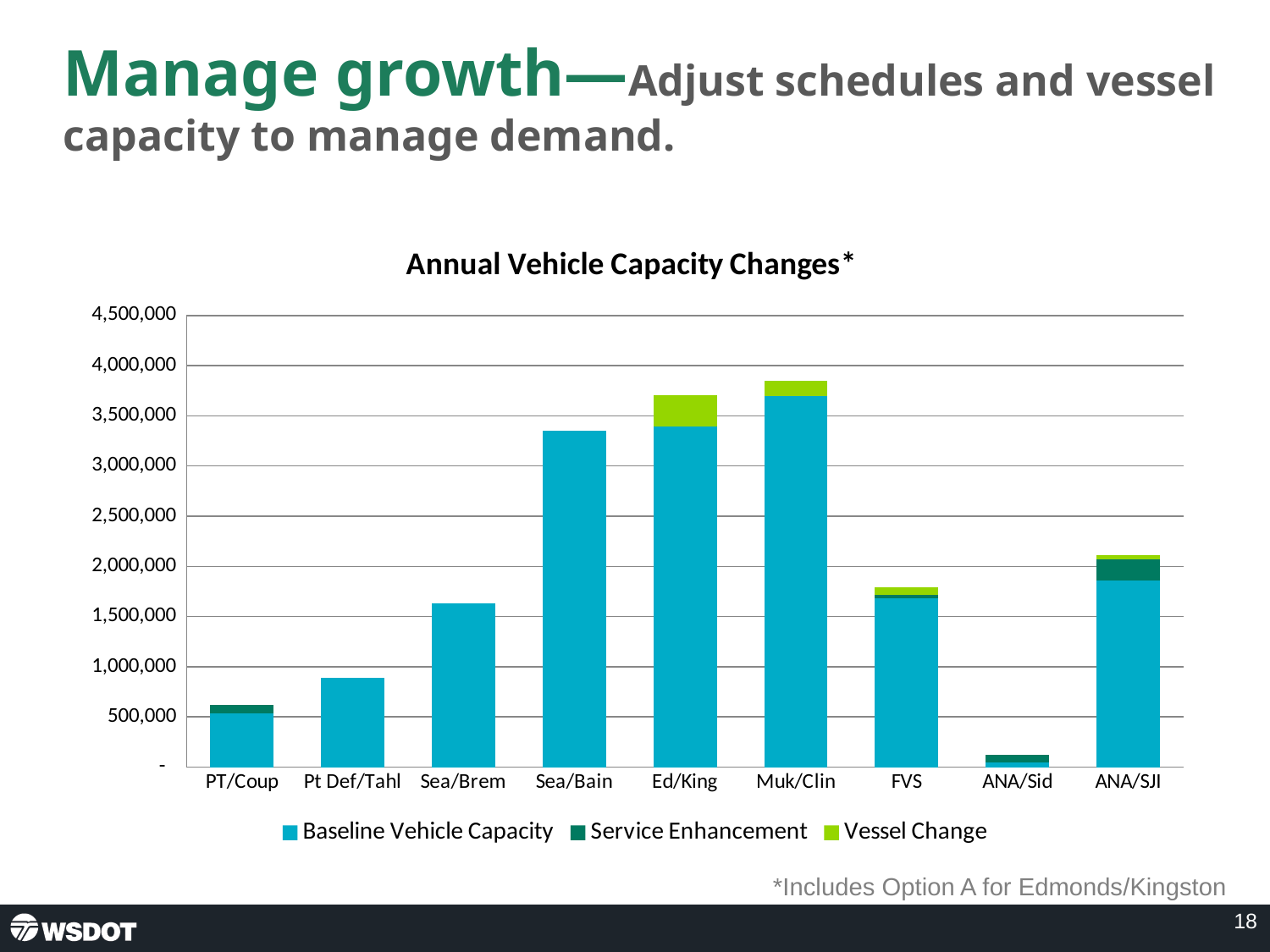
What is the title of the chart? Annual Vehicle Capacity Changes* Which route has the highest total annual vehicle capacity? Muk/Clin Which series is shown in the light green colour in the legend? Vessel Change Is the total value for Sea/Brem greater or less than 1,500,000? greater Which route has the lowest total annual vehicle capacity? ANA/Sid Which has the larger total annual vehicle capacity, Sea/Bain or Sea/Brem? Sea/Bain Is the total value for Sea/Bain greater or less than 3,000,000? greater Is the total value for Pt Def/Tahl greater or less than 1,000,000? less How many routes (categories) are shown on the x axis? 9 How many series does the legend list? 3 What kind of chart is shown on the slide? Stacked bar chart